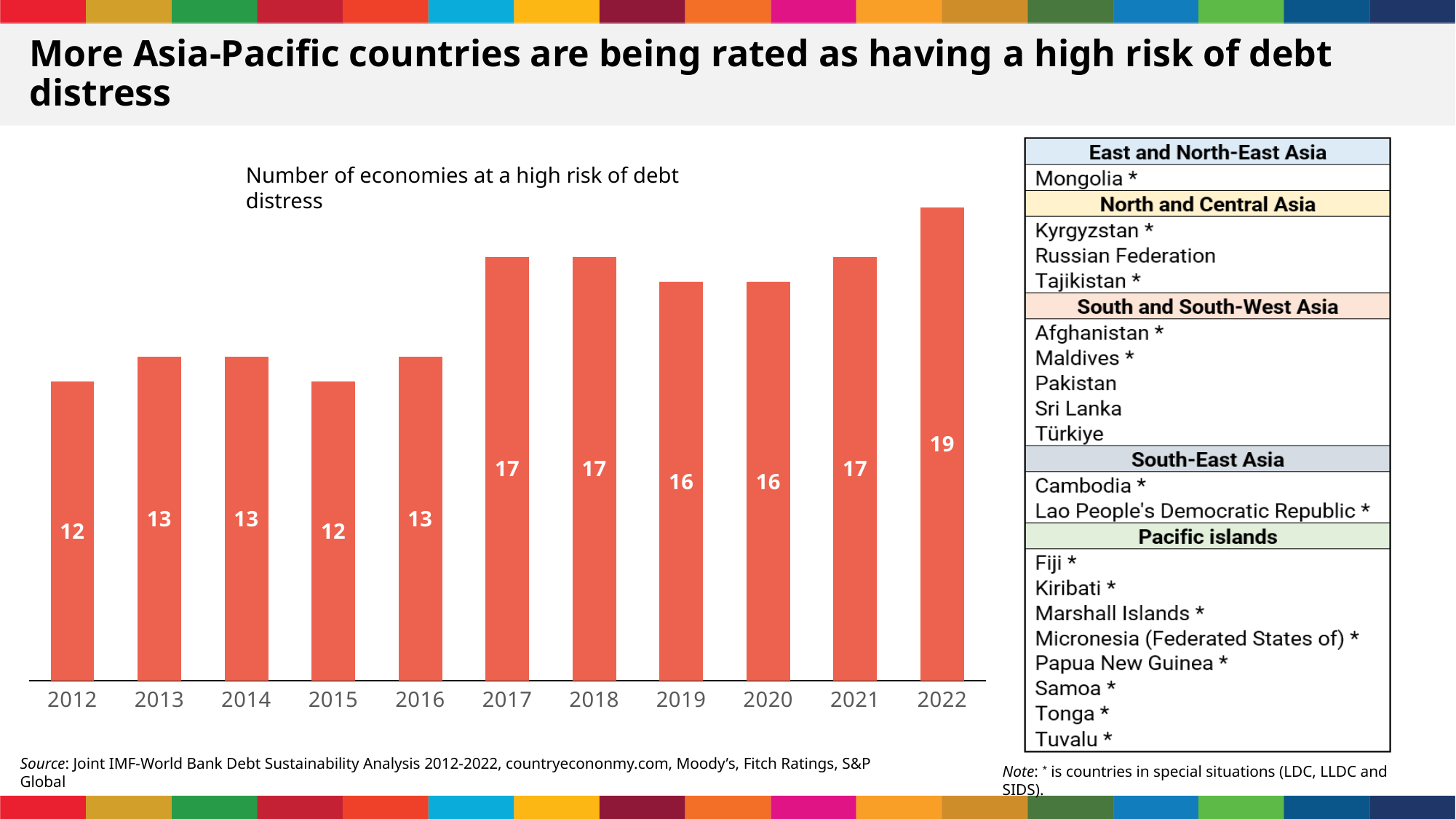
What kind of chart is used to show the number of economies at a high risk of debt distress? Bar chart What is the number of economies at a high risk of debt distress in 2016? 13 How many years are shown on the x axis of the chart? 11 Which years share the lowest value on the chart? 2012 and 2015 Which is larger, the value for 2018 or the value for 2020? 2018 What is the difference between the values for 2017 and 2016? 4 What is the difference between the values for 2022 and 2012? 7 Which year has the highest number of economies at a high risk of debt distress? 2022 What is the value shown for 2019? 16 What is the title of the chart on the left of the slide? Number of economies at a high risk of debt distress What is the number of economies at a high risk of debt distress in 2022? 19 Overall, do the values rise or fall from 2012 to 2022? Rise